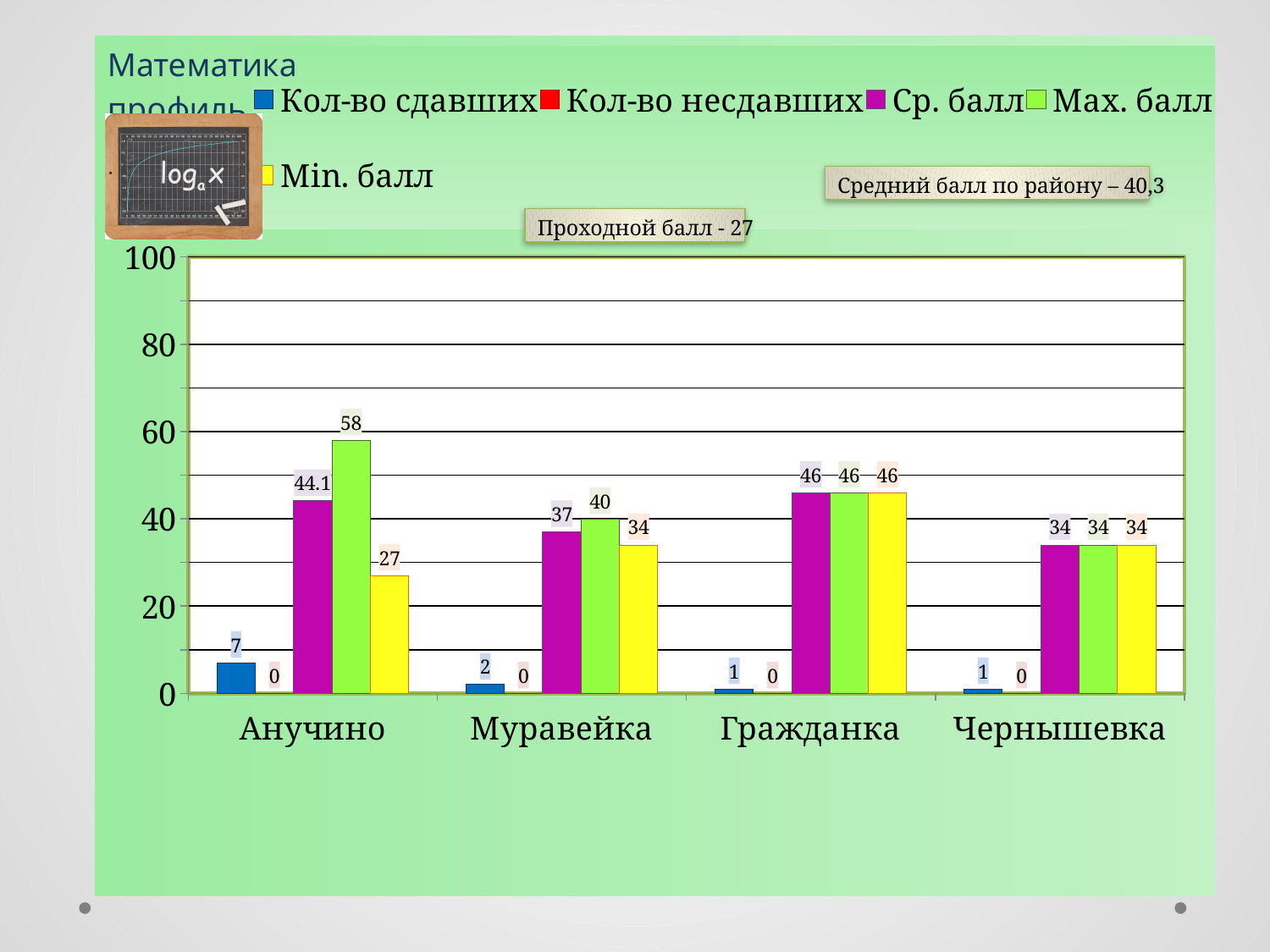
How many categories are shown on the x axis? 4 What is the difference between Max. балл and Min. балл for Анучино? 31 What is the value of Min. балл for Муравейка? 34 How many series does the legend list? 5 What is the value of Ср. балл for Анучино? 44.1 What is the value of Max. балл for Анучино? 58 Which category has the highest value for Кол-во сдавших? Анучино What type of chart is shown on the slide? bar chart Which is larger: Ср. балл for Гражданка or Ср. балл for Муравейка? Гражданка What is the value of Кол-во сдавших for Муравейка? 2 What is the value of Кол-во несдавших for Гражданка? 0 Which category has the lowest value for Ср. балл? Чернышевка